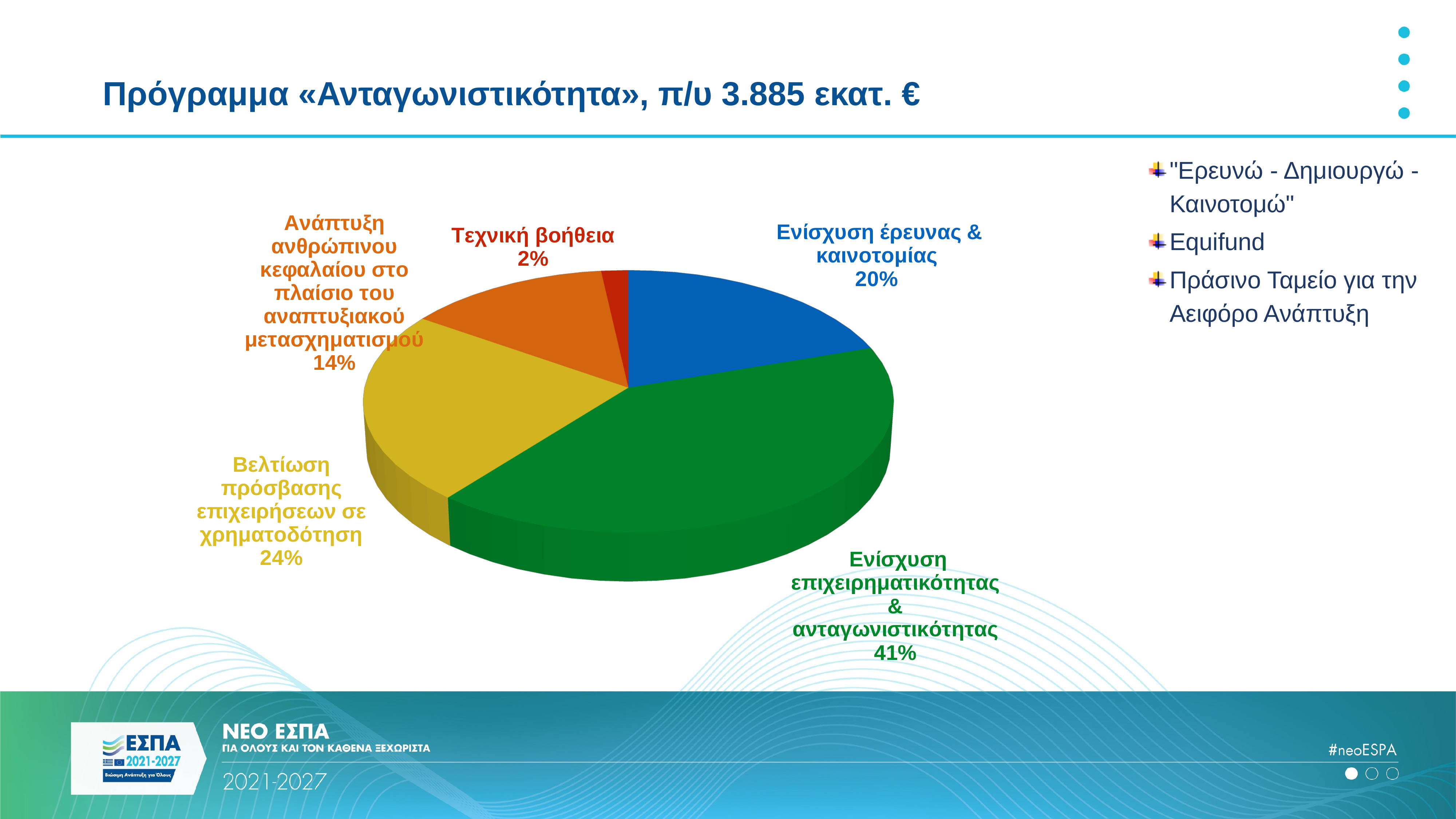
How many slices does the pie chart have? 5 What share of the pie does "Ανάπτυξη ανθρώπινου κεφαλαίου στο πλαίσιο του αναπτυξιακού μετασχηματισμού" have? 14% What colour is the slice for "Βελτίωση πρόσβασης επιχειρήσεων σε χρηματοδότηση"? Yellow What share of the pie does "Τεχνική βοήθεια" have? 2% What share of the pie does "Βελτίωση πρόσβασης επιχειρήσεων σε χρηματοδότηση" have? 24% What is the difference in percentage points between "Ενίσχυση επιχειρηματικότητας & ανταγωνιστικότητας" and "Βελτίωση πρόσβασης επιχειρήσεων σε χρηματοδότηση"? 17 percentage points What kind of chart is shown on the slide? Pie chart Which slice of the pie is the smallest? Τεχνική βοήθεια Which is larger: the share for "Ενίσχυση έρευνας & καινοτομίας" or the share for "Ανάπτυξη ανθρώπινου κεφαλαίου στο πλαίσιο του αναπτυξιακού μετασχηματισμού"? Ενίσχυση έρευνας & καινοτομίας Which slice of the pie is the largest? Ενίσχυση επιχειρηματικότητας & ανταγωνιστικότητας